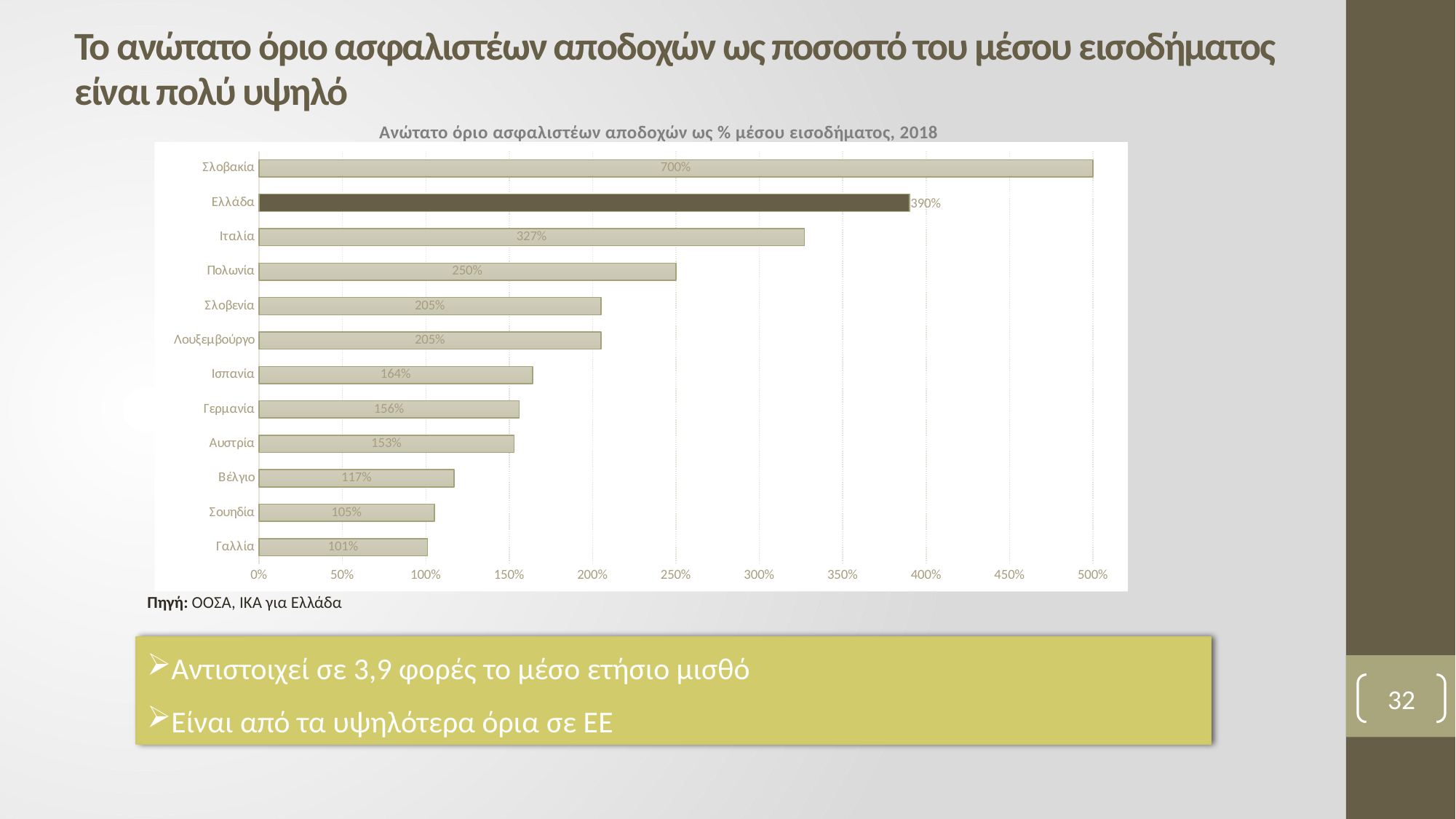
Which is larger, the value for Γερμανία or the value for Βέλγιο? Γερμανία What is the value for Λουξεμβούργο? 205% What is the difference between the values for Πολωνία and Ισπανία? 86% What is the value for Ιταλία? 327% What kind of chart is this? Bar chart Which country has the lowest value? Γαλλία Which country has the highest value? Σλοβακία What is the value for Γαλλία? 101% What is the title of the chart? Ανώτατο όριο ασφαλιστέων αποδοχών ως % μέσου εισοδήματος, 2018 What is the difference between the values for Σλοβακία and Ελλάδα? 310% What is the value for Ελλάδα? 390% How many countries are shown in the chart? 12